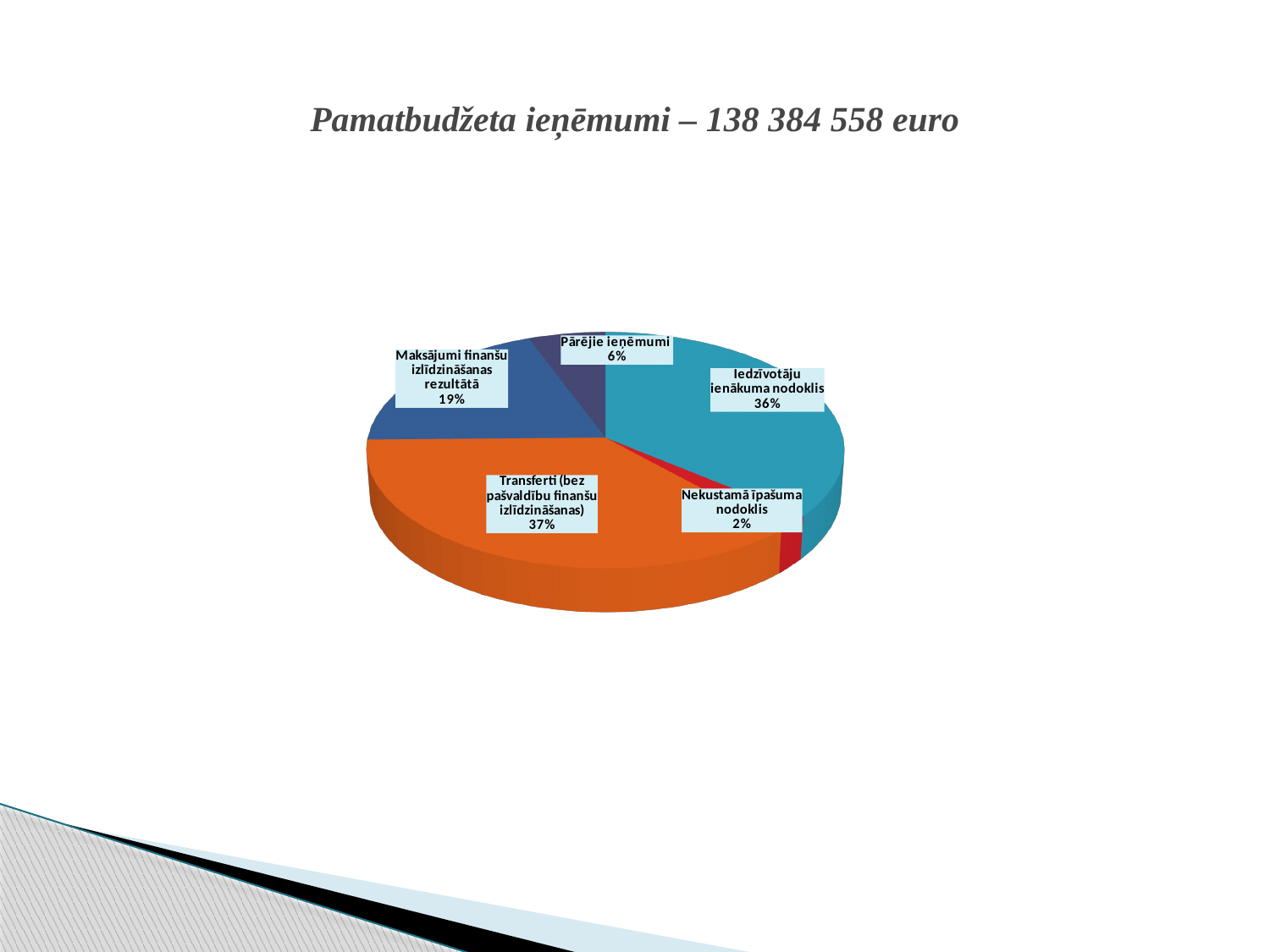
How many categories are shown in the pie chart? 5 What type of chart is shown on the slide? Pie chart Which is larger: the share for Iedzīvotāju ienākuma nodoklis or the share for Maksājumi finanšu izlīdzināšanas rezultātā? Iedzīvotāju ienākuma nodoklis What share of the pie does Iedzīvotāju ienākuma nodoklis represent? 36% What total amount in euro is stated in the chart title? 138 384 558 euro Which category has the largest slice of the pie? Transferti (bez pašvaldību finanšu izlīdzināšanas) What is the difference in percentage points between Maksājumi finanšu izlīdzināšanas rezultātā and Pārējie ieņēmumi? 13 What percentage is shown for Maksājumi finanšu izlīdzināšanas rezultātā? 19% Which category has the smallest slice of the pie? Nekustamā īpašuma nodoklis What percentage is shown for Pārējie ieņēmumi? 6% What percentage is shown for Transferti (bez pašvaldību finanšu izlīdzināšanas)? 37% What percentage is shown for Nekustamā īpašuma nodoklis? 2%